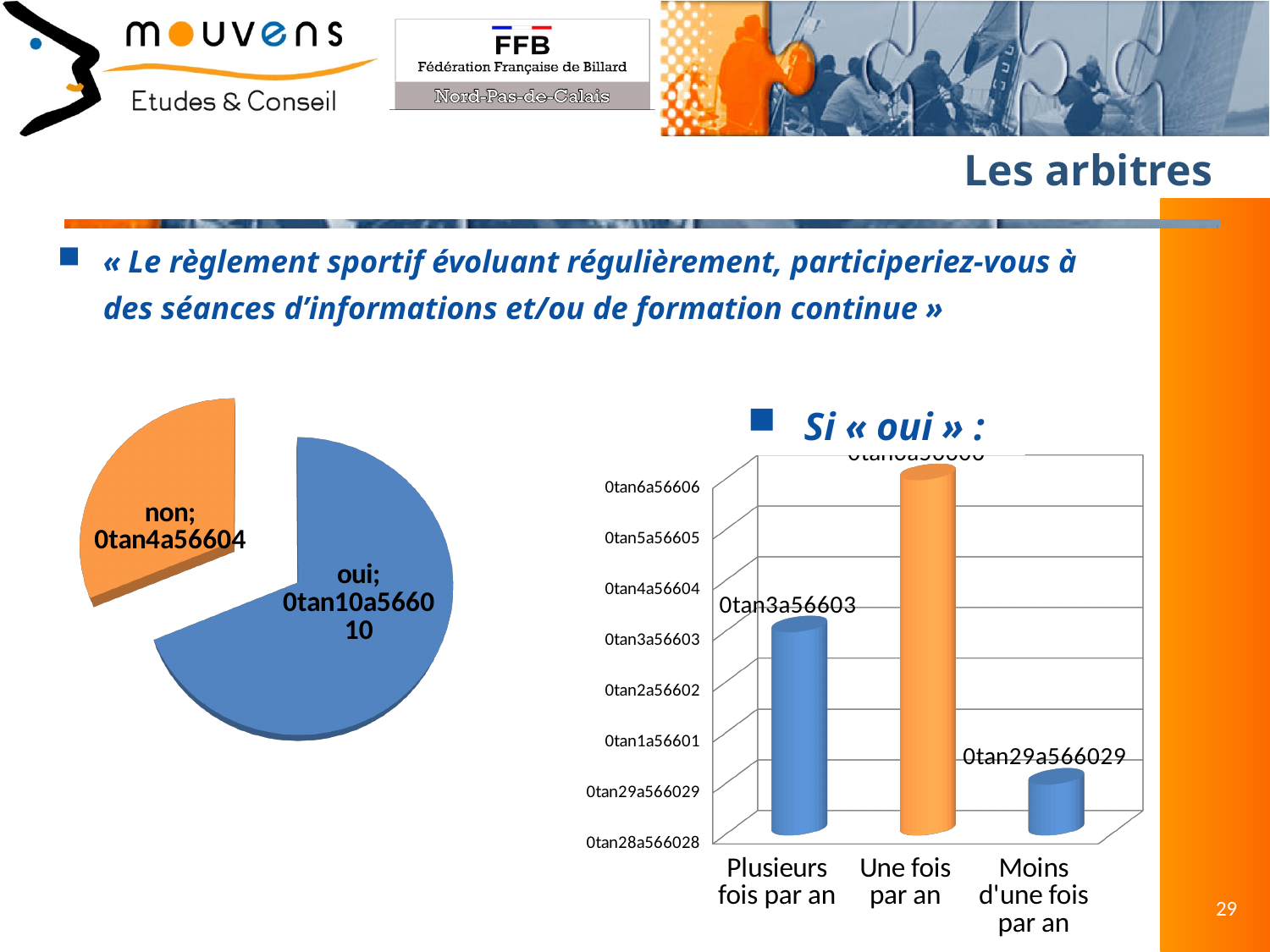
In the bar chart on the right, which category has the highest bar? Une fois par an In the bar chart on the right, what colour is the bar for Une fois par an? orange In the pie chart on the left, what colour is the oui slice? blue What kind of chart is the chart on the right of the slide, under "Si « oui » :"? bar chart What kind of chart is the chart on the left of the slide? pie chart In the bar chart on the right, which bar is taller, Plusieurs fois par an or Moins d'une fois par an? Plusieurs fois par an In the pie chart on the left, which slice is the largest? oui In the bar chart on the right, which category has the lowest bar? Moins d'une fois par an In the pie chart on the left, how many slices are there? 2 In the pie chart on the left, which slice is larger, oui or non? oui In the bar chart on the right, how many categories are shown on the x axis? 3 In the pie chart on the left, which slice is the smallest? non